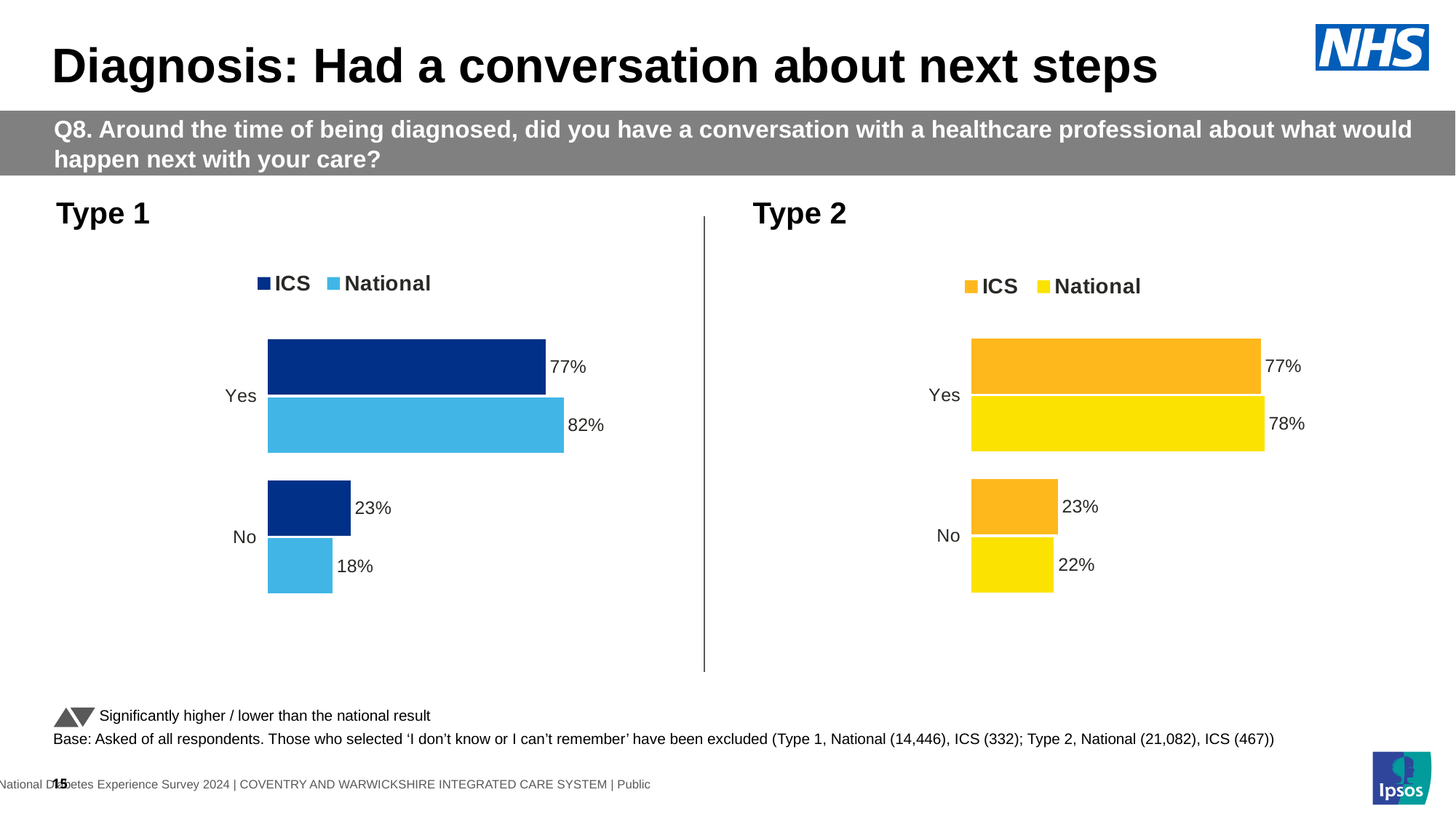
In the Type 1 chart, what is the National value for Yes? 82% In the Type 2 chart, what is the ICS value for No? 23% In the Type 2 chart, what is the difference between the ICS and National values for No? 1 percentage point How many series does the legend of the Type 2 chart list? 2 What kind of chart is the Type 2 chart? Bar chart In the Type 1 chart, what is the difference between the National and ICS values for Yes? 5 percentage points In the Type 1 chart, which is larger for No: ICS or National? ICS In the Type 2 chart, what is the National value for Yes? 78% In the Type 1 chart, what is the ICS value for Yes? 77% How many categories are shown in the Type 1 chart? 2 In the Type 1 chart, which series has the highest value for Yes? National In the Type 1 chart, what is the National value for No? 18%